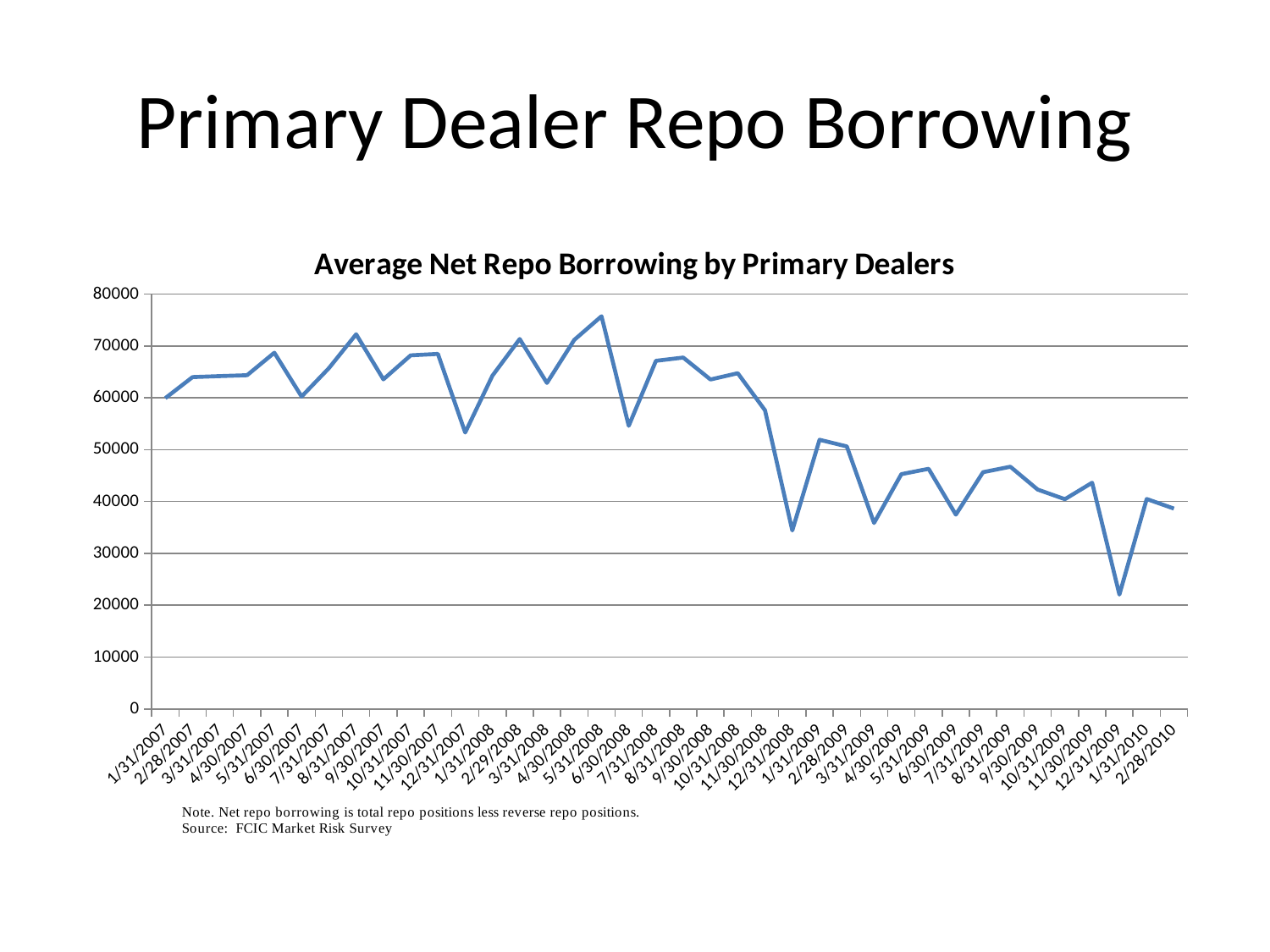
Is the value for 12/31/2008 greater or less than 40000? less What kind of chart is shown on the slide? line chart Is the value for 5/31/2008 greater or less than 70000? greater On which date does the line reach its lowest value? 12/31/2009 Which is larger, the value for 8/31/2007 or the value for 12/31/2008? 8/31/2007 Is the value for 12/31/2007 greater or less than 60000? less What source is cited below the chart? FCIC Market Risk Survey On which date does the line reach its highest value? 5/31/2008 What is the title of the chart? Average Net Repo Borrowing by Primary Dealers How many data points (monthly dates) are plotted on the x axis? 38 Overall, do the values rise or fall from 1/31/2007 to 2/28/2010? fall